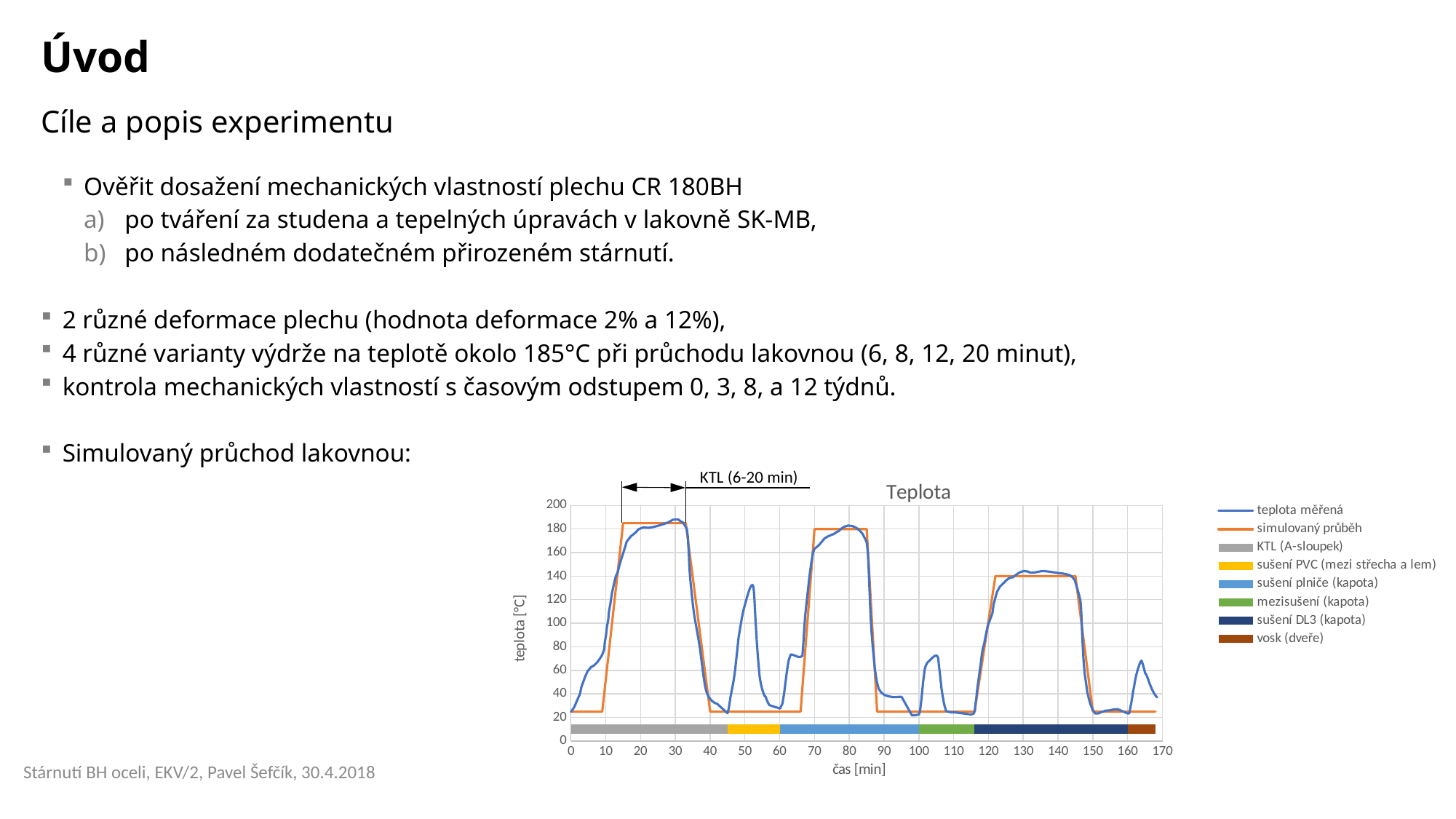
What is the highest value shown on the y axis of the "Teplota" chart? 200 Is the value of "simulovaný průběh" at 130 min greater or less than 120? greater What kind of chart is the "Teplota" chart? line chart Is the value of "teplota měřená" at 160 min greater or less than 60? less Does the "simulovaný průběh" line rise or fall between 30 min and 40 min? fall What is the title of the chart on the slide? Teplota How many entries does the legend of the "Teplota" chart list? 8 What is the highest value shown on the x axis of the "Teplota" chart? 170 What is the label of the x axis of the "Teplota" chart? čas [min] Is the value of "simulovaný průběh" at 20 min greater or less than 160? greater Which is larger for "simulovaný průběh": the value at 20 min or the value at 130 min? the value at 20 min